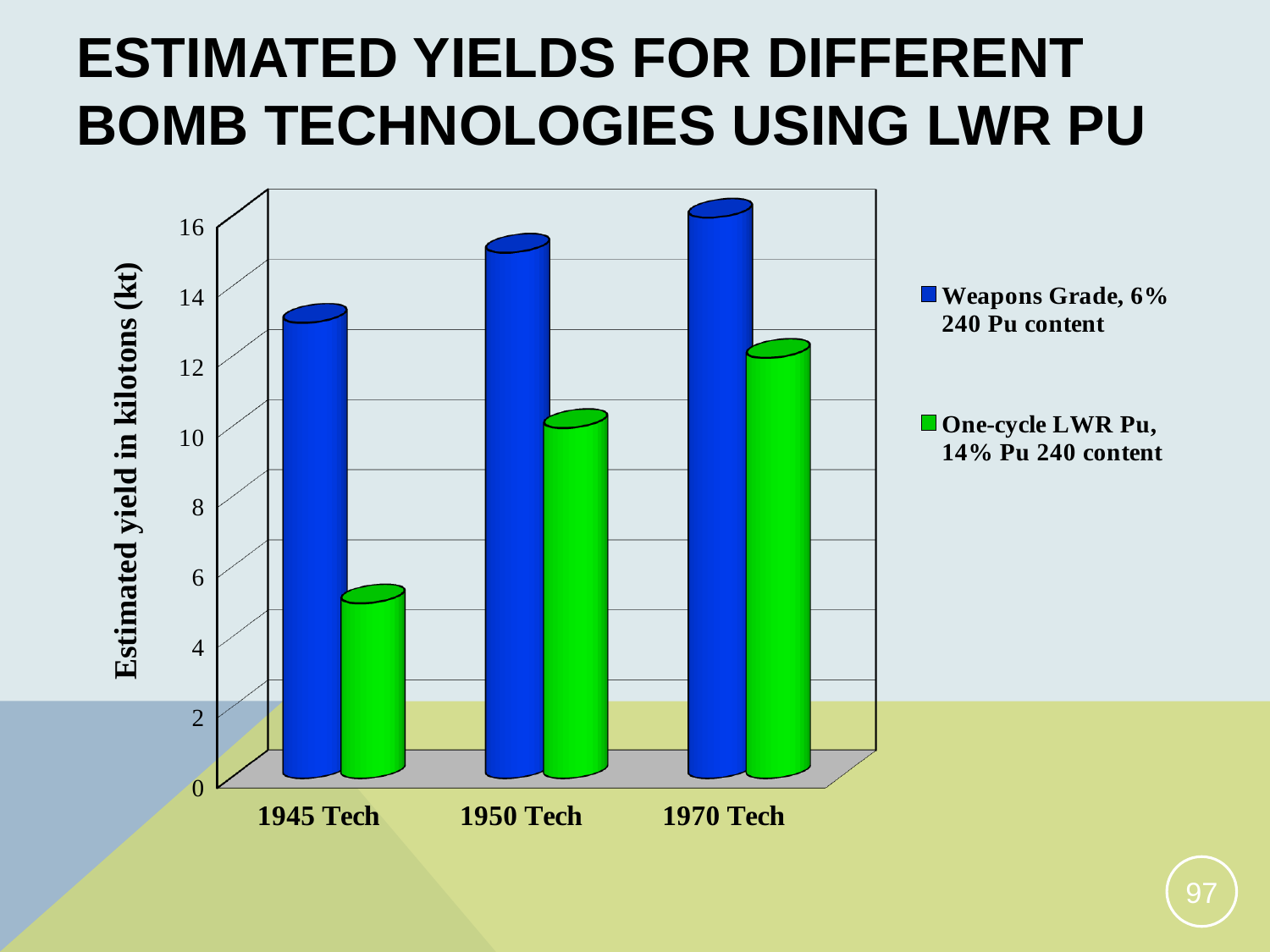
Is the One-cycle LWR Pu, 14% Pu 240 content value for 1945 Tech greater or less than 6? less Which technology category has the lowest One-cycle LWR Pu, 14% Pu 240 content yield? 1945 Tech What kind of chart is shown on the slide? bar chart Is the One-cycle LWR Pu, 14% Pu 240 content value for 1970 Tech greater or less than 10? greater How many technology categories are shown on the x axis? 3 For 1950 Tech, which is larger: the Weapons Grade yield or the One-cycle LWR Pu yield? Weapons Grade How many series does the legend list? 2 What is the title of the vertical axis? Estimated yield in kilotons (kt) Is the Weapons Grade, 6% 240 Pu content value for 1950 Tech greater or less than 14? greater Do the Weapons Grade, 6% 240 Pu content yields rise or fall from 1945 Tech to 1970 Tech? rise Which colour represents the One-cycle LWR Pu, 14% Pu 240 content series? green Which technology category has the highest Weapons Grade, 6% 240 Pu content yield? 1970 Tech